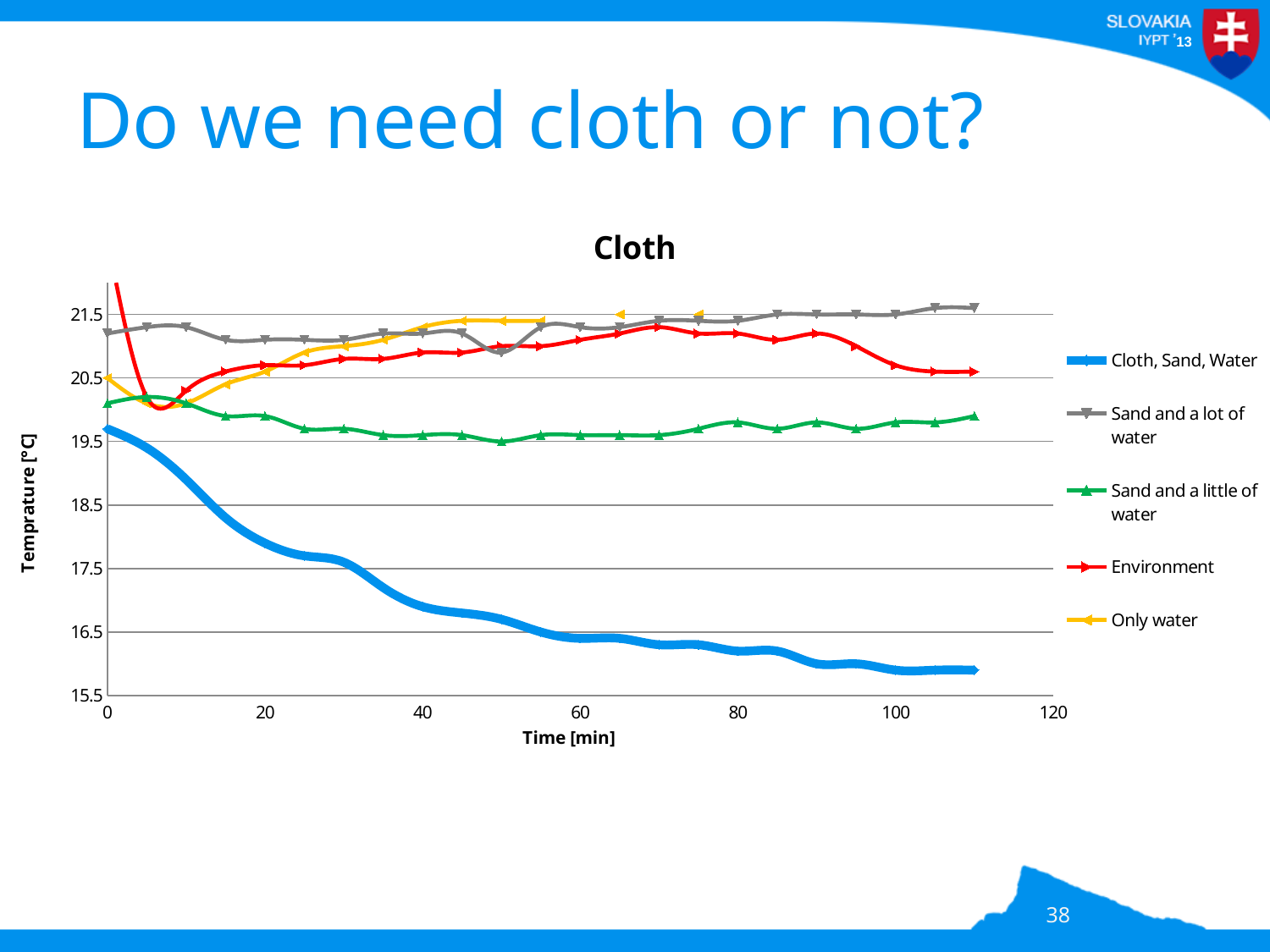
At 100 min, which is higher: 'Sand and a lot of water' or 'Environment'? Sand and a lot of water What is the title of the chart? Cloth Does the 'Cloth, Sand, Water' series rise or fall as time increases? fall Is the value of the 'Environment' series at 60 min greater or less than 20.5? greater What kind of chart is shown on the slide? line chart How many series does the legend of the chart list? 5 Which series has the highest value at 110 min? Sand and a lot of water Is the value of the 'Environment' series at 0 min greater or less than 21.5? greater Which series has the lowest value at 110 min? Cloth, Sand, Water What is the label of the x axis of the chart? Time [min] Is the value of the 'Cloth, Sand, Water' series at 40 min greater or less than 17.5? less